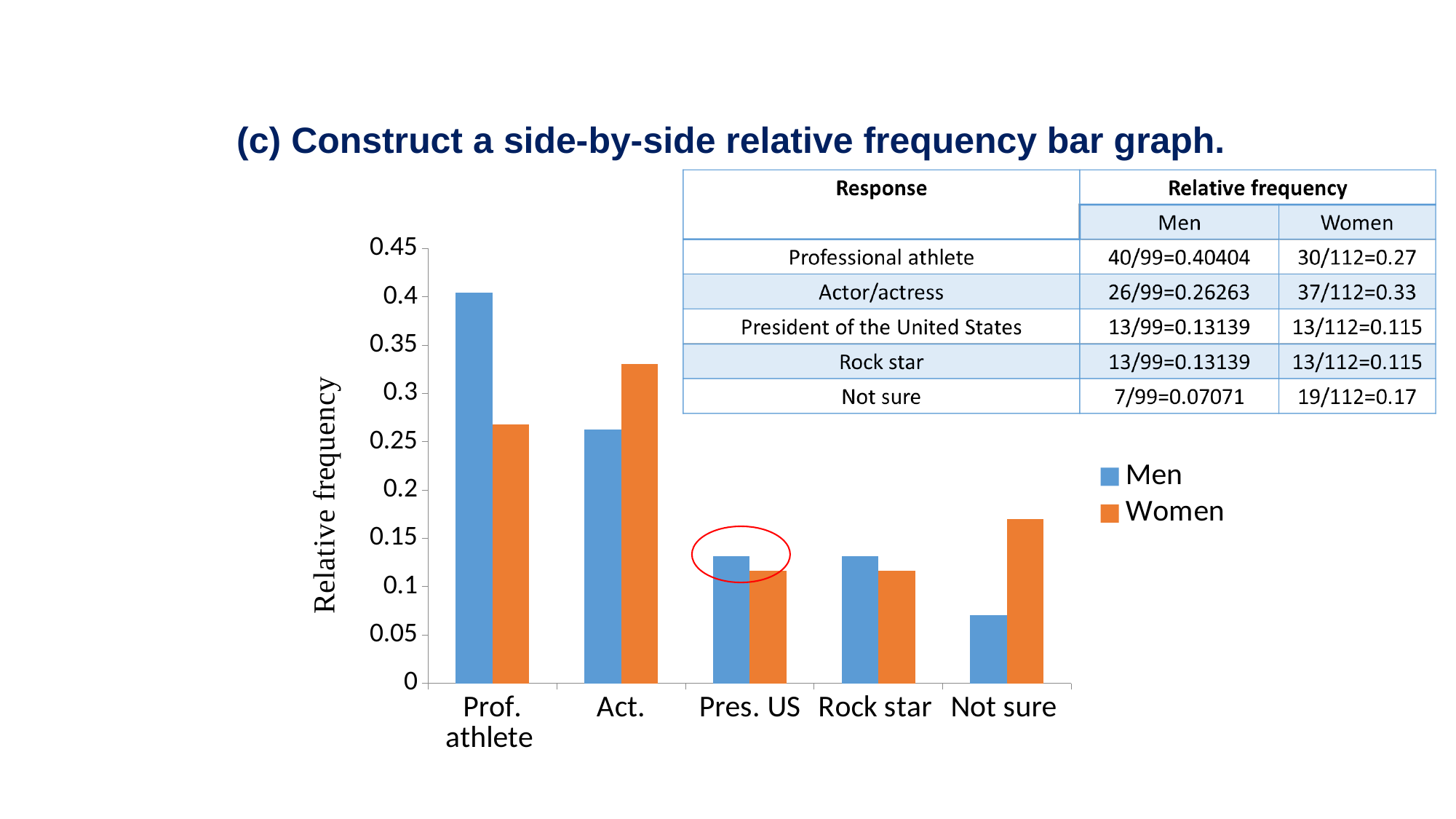
What kind of chart is shown on the slide? bar chart For Prof. athlete, which series has the larger bar, Men or Women? Men Is the Men bar for Not sure greater or less than 0.1? less Which category has the highest relative frequency for Men? Prof. athlete How many response categories are shown on the x axis of the chart? 5 Is the Men bar for Prof. athlete greater or less than 0.35? greater How many series does the chart's legend list? 2 Which category has the lowest relative frequency for Men? Not sure Which category has the highest relative frequency for Women? Act. What is the label on the vertical axis of the chart? Relative frequency For Not sure, which series has the larger bar, Men or Women? Women Is the Women bar for Act. greater or less than 0.3? greater